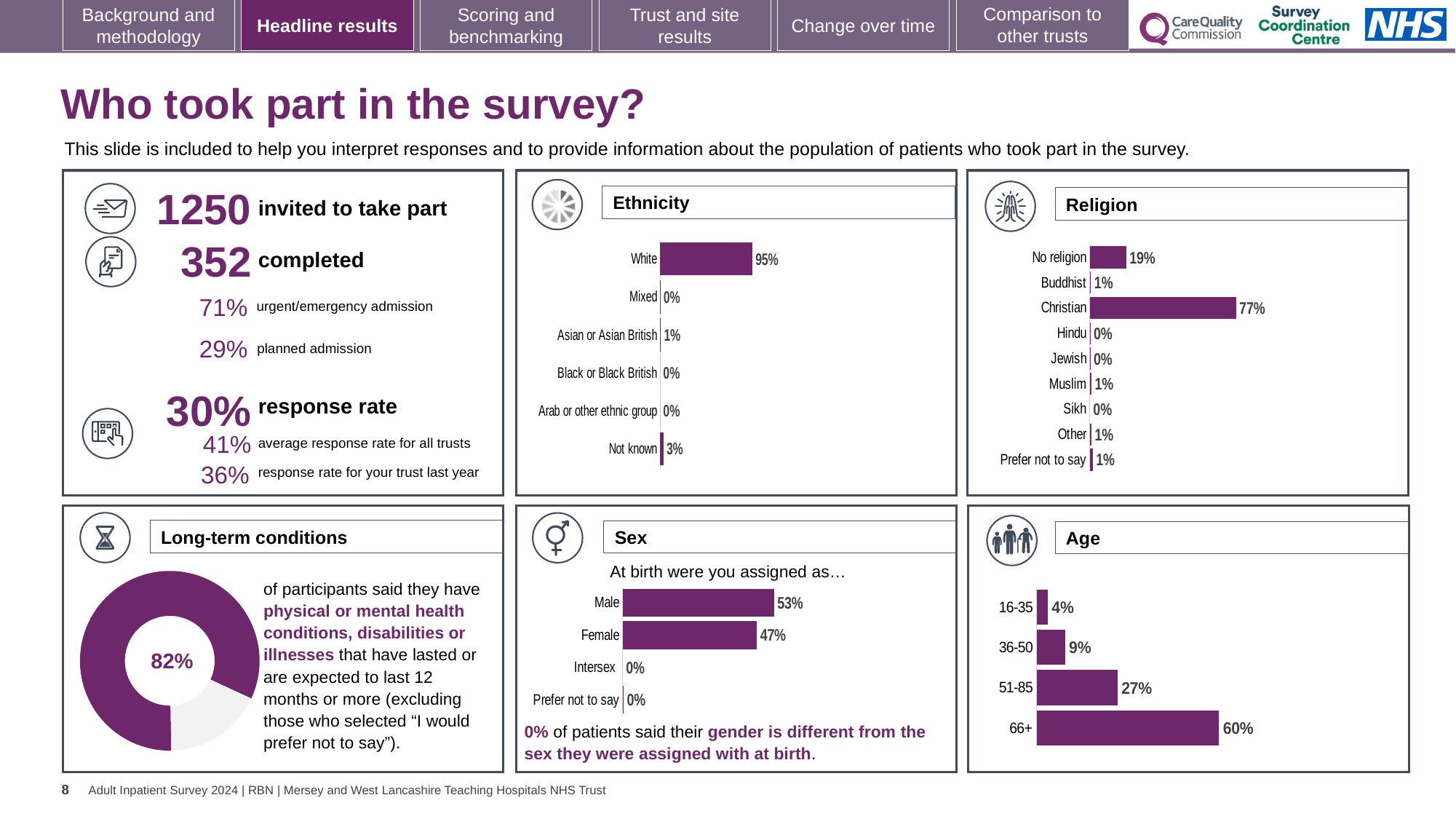
In the Sex chart, which is larger, Male or Female? Male In the Sex chart, what is the value for Female? 47% In the Age chart, do the values rise or fall as the age groups get older? rise In the Ethnicity chart, what percentage of participants are Not known? 3% In the Religion chart, how many categories are shown? 9 In the Long-term conditions chart, what share of participants said they have physical or mental health conditions, disabilities or illnesses? 82% In the Age chart, what is the value for 51-85? 27% In the Religion chart, what is the value for No religion? 19% In the Age chart, which age group has the lowest value? 16-35 In the Ethnicity chart, what percentage of participants are White? 95% In the Religion chart, what is the difference between Christian and No religion? 58% In the Religion chart, which category has the highest value? Christian